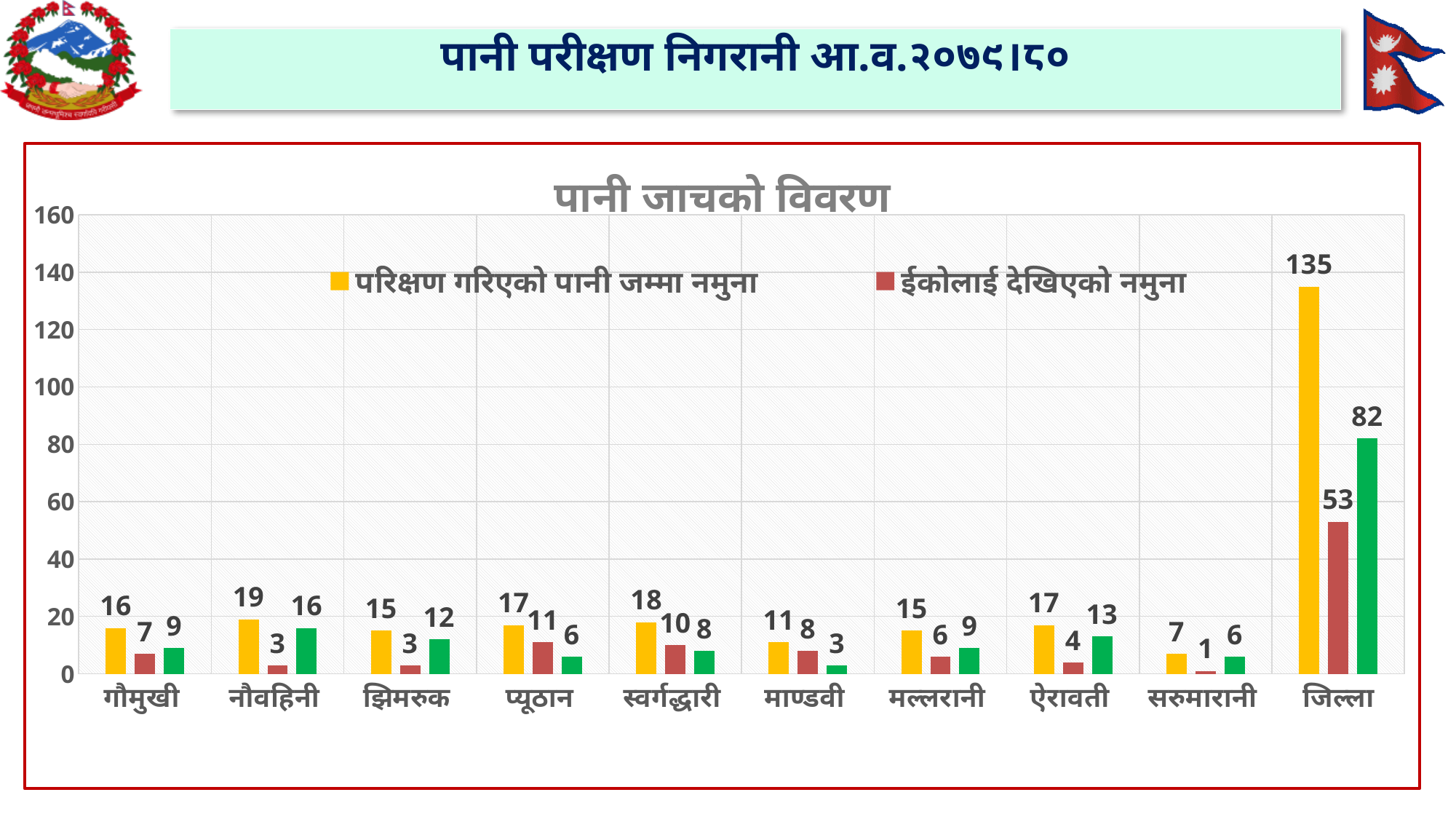
What is the title of the chart? पानी जाचको विवरण Which is larger for नौवहिनी: the ईकोलाई देखिएको नमुना value or the green bar value? the green bar value What is the value of the green bar for ऐरावती? 13 How many series does the legend list? 2 Which category has the lowest value for परिक्षण गरिएको पानी जम्मा नमुना? सरुमारानी How many categories are shown on the x axis? 10 Is the value of परिक्षण गरिएको पानी जम्मा नमुना for जिल्ला greater or less than 120? greater What is the value of ईकोलाई देखिएको नमुना for प्यूठान? 11 Which category has the highest value for ईकोलाई देखिएको नमुना? जिल्ला What is the difference between परिक्षण गरिएको पानी जम्मा नमुना and ईकोलाई देखिएको नमुना for जिल्ला? 82 What kind of chart is shown on the slide? bar chart What is the value of परिक्षण गरिएको पानी जम्मा नमुना for जिल्ला? 135